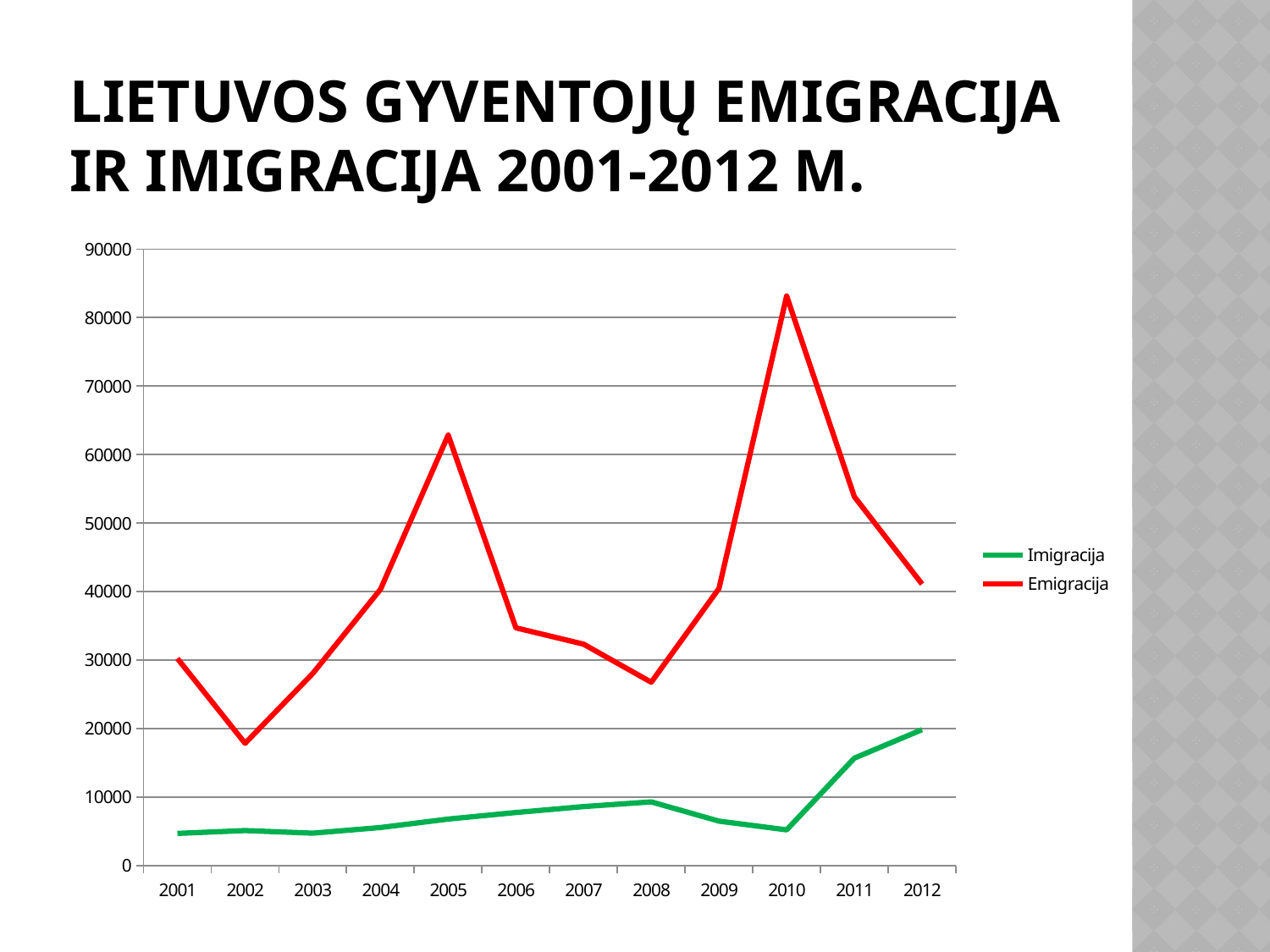
Does the Imigracija series rise or fall from 2010 to 2012? rise How many series does the legend list? 2 In which year does the Emigracija series reach its highest value? 2010 Is the Emigracija value for 2010 greater or less than 80000? greater Is the Imigracija value for 2011 greater or less than 10000? greater How many years are plotted along the x axis? 12 Which colour is used for the Emigracija series? red In which year does the Emigracija series reach its lowest value? 2002 What kind of chart is shown on the slide? line chart In which year does the Imigracija series reach its highest value? 2012 Is the Emigracija value for 2002 greater or less than 20000? less Which is larger, the Emigracija value for 2005 or for 2010? 2010